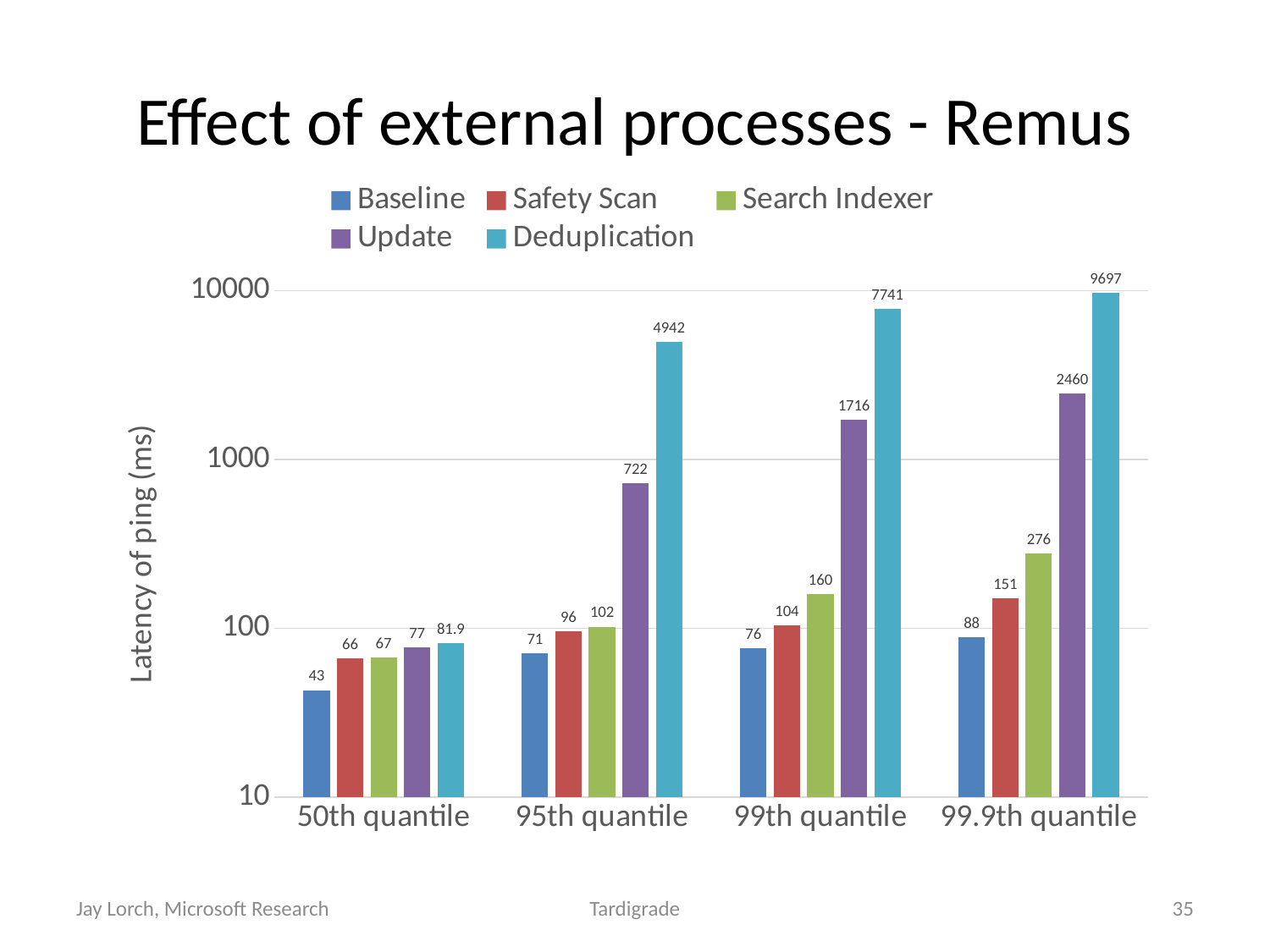
Which series has the lowest latency at the 99.9th quantile? Baseline What is the difference between the Deduplication and Update latencies at the 99.9th quantile? 7237 What is the label of the y axis? Latency of ping (ms) What is the Deduplication latency at the 99.9th quantile? 9697 How many series does the legend list? 5 How many quantile categories are shown on the x axis? 4 Which series has the highest latency at the 99th quantile? Deduplication Which is larger: the Safety Scan latency at the 95th quantile or the Search Indexer latency at the 95th quantile? Search Indexer What is the Update latency at the 95th quantile? 722 What kind of chart is shown on the slide? Bar chart What is the Baseline latency at the 50th quantile? 43 What is the Search Indexer latency at the 99th quantile? 160